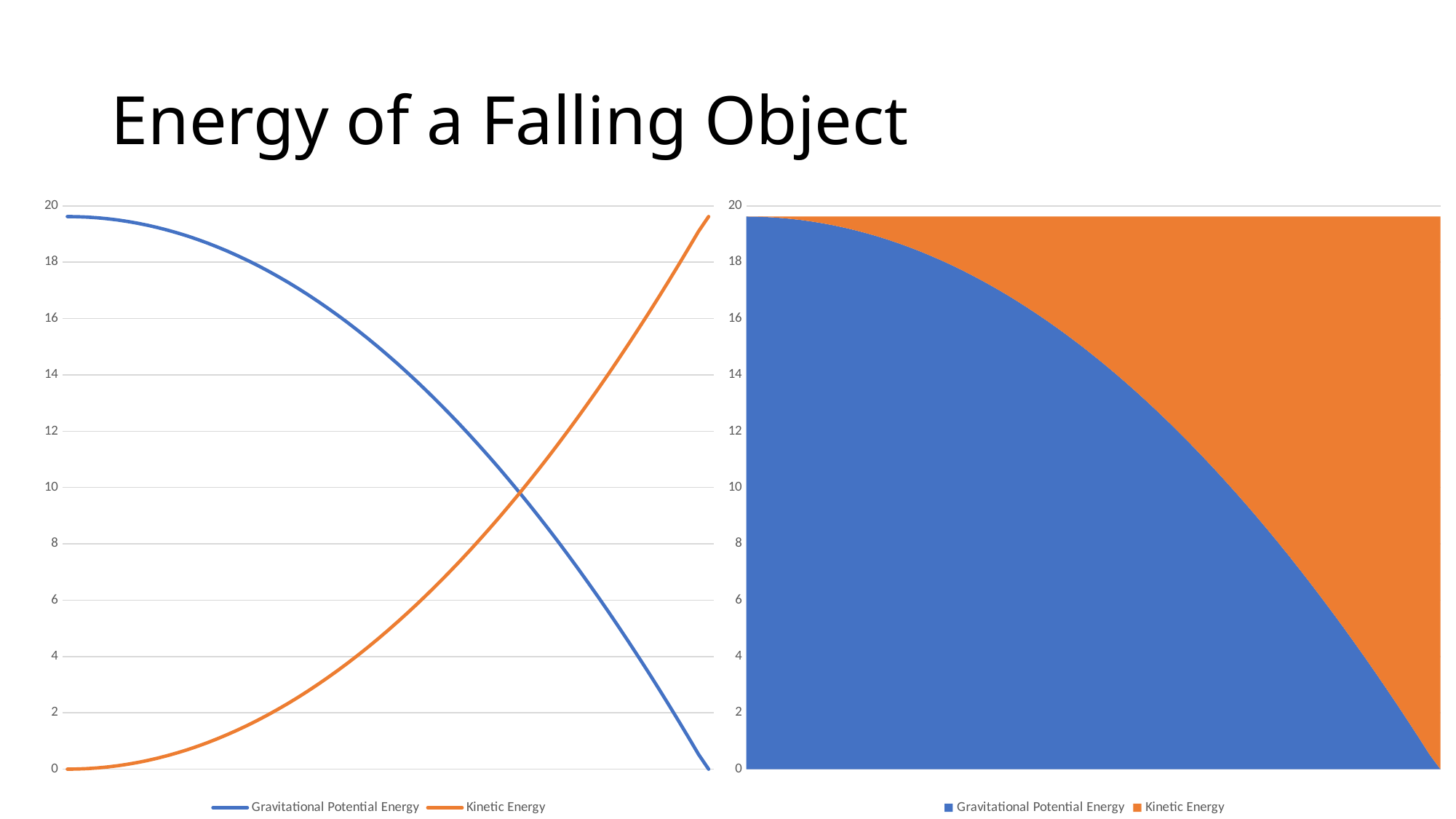
What kind of chart is the chart on the right of the slide? area chart In the left chart, does the Gravitational Potential Energy line rise or fall along the x axis? fall In the left chart, is the starting value of Gravitational Potential Energy greater or less than 18? greater In the right chart, which colour represents Kinetic Energy? orange In the left chart, does the Kinetic Energy line rise or fall along the x axis? rise In the left chart, is the starting value of Kinetic Energy greater or less than 2? less In the left chart, how many series does the legend list? 2 In the right chart, how many series does the legend list? 2 What is the title of the slide? Energy of a Falling Object In the left chart, at the left end of the x axis, which series has the larger value, Gravitational Potential Energy or Kinetic Energy? Gravitational Potential Energy What kind of chart is the chart on the left of the slide? line chart In the left chart, at the right end of the x axis, which series has the larger value, Gravitational Potential Energy or Kinetic Energy? Kinetic Energy